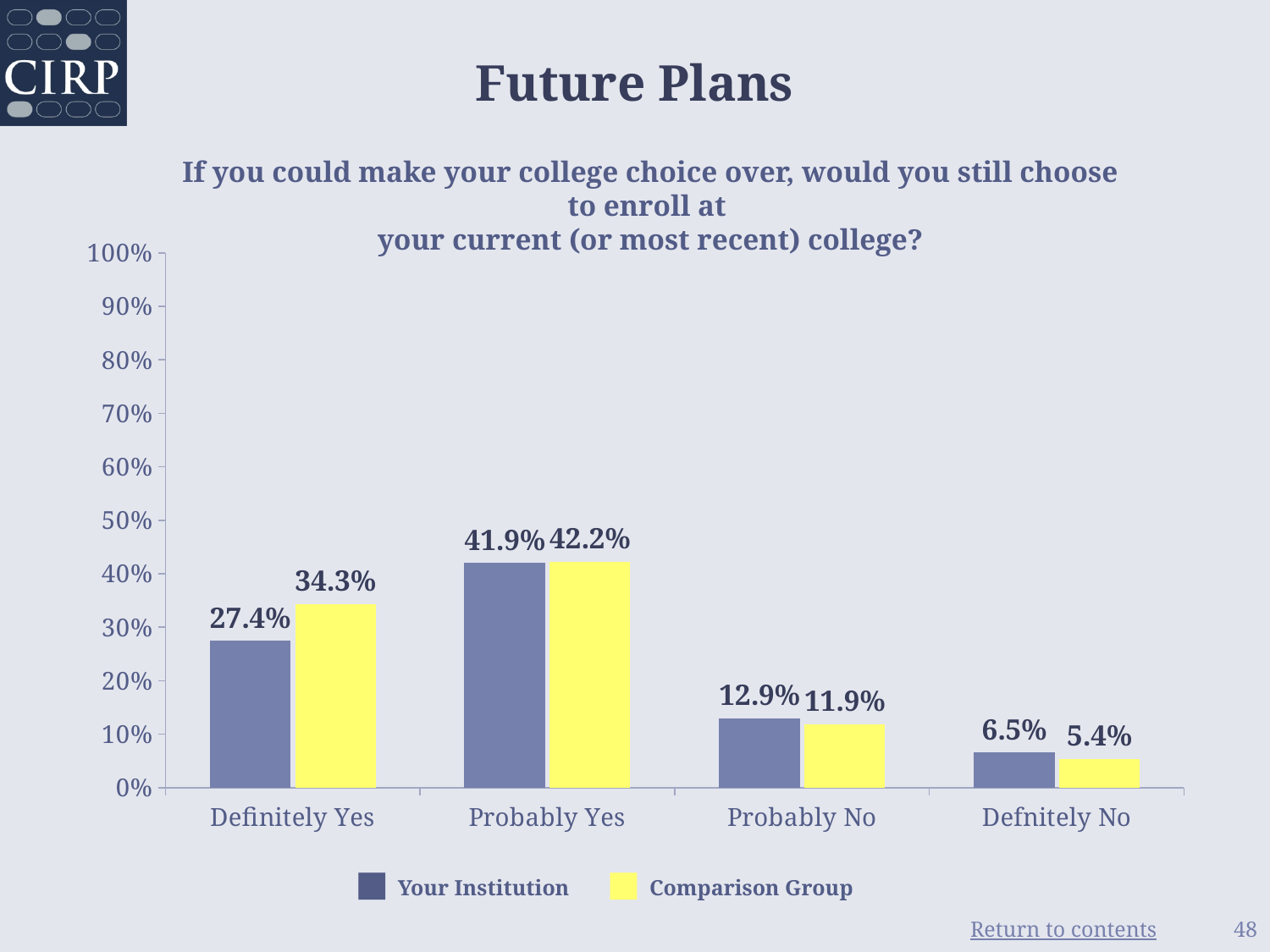
Which category has the lowest value for Comparison Group? Defnitely No What is the difference between Comparison Group and Your Institution in the Definitely Yes category? 6.9% What colour represents the Comparison Group series? yellow What kind of chart is shown on the slide? bar chart What is the value for Comparison Group in the Probably No category? 11.9% Which category has the highest value for Your Institution? Probably Yes What is the value for Your Institution in the Definitely Yes category? 27.4% How many categories are shown on the x axis? 4 How many series does the legend list? 2 Is the value for Comparison Group in the Probably Yes category greater or less than 40%? greater In the Probably No category, which series has the larger value, Your Institution or Comparison Group? Your Institution What is the value for Comparison Group in the Defnitely No category? 5.4%